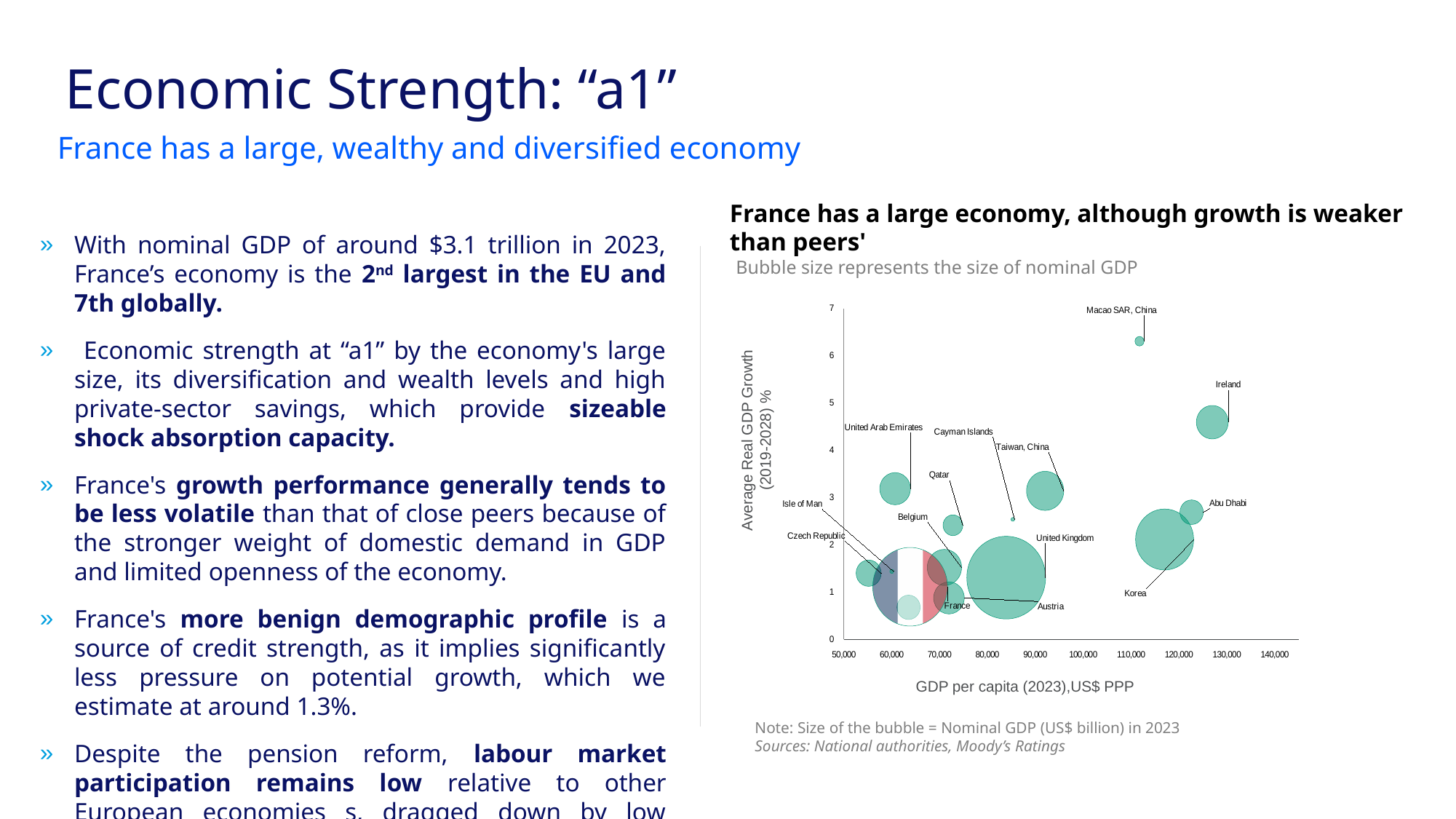
What does the bubble size represent in the chart? Nominal GDP (US$ billion) in 2023 Which economy has the highest average real GDP growth (2019-2028) in the chart? Macao SAR, China Which has higher average real GDP growth, Macao SAR, China or Taiwan, China? Macao SAR, China Is the average real GDP growth for Qatar greater or less than 3%? less What is the label of the x axis of the chart? GDP per capita (2023),US$ PPP Which has higher average real GDP growth, Ireland or the United Kingdom? Ireland Is the GDP per capita (2023) for Korea greater or less than 110,000? greater Is the average real GDP growth for Macao SAR, China greater or less than 6%? greater How many labelled economies are plotted in the chart? 14 What kind of chart is shown on the slide? bubble chart